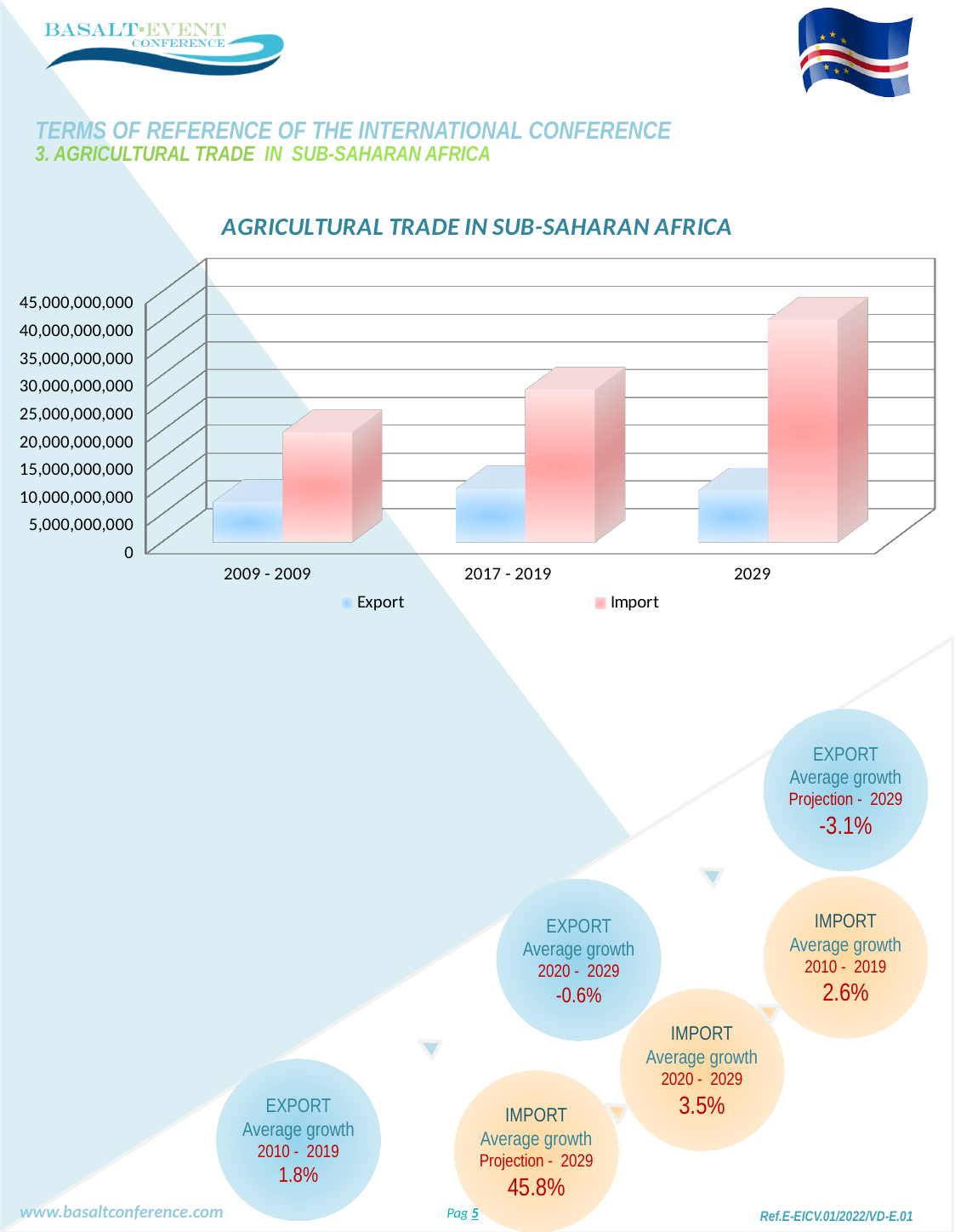
How many series does the chart legend list? 2 How many categories are shown on the x axis of the chart? 3 In 2029, which is larger, Export or Import? Import What is the title of the chart? AGRICULTURAL TRADE IN SUB-SAHARAN AFRICA Do the Import values rise or fall from 2009 - 2009 to 2029? rise Which two series are listed in the chart legend? Export and Import In which category is the Import value highest? 2029 Is the Export value for 2009 - 2009 greater or less than 15,000,000,000? less Is the Import value for 2029 greater or less than 35,000,000,000? greater In which category is the Import value lowest? 2009 - 2009 Is the Import value for 2009 - 2009 greater or less than 25,000,000,000? less What kind of chart is shown on the slide? bar chart